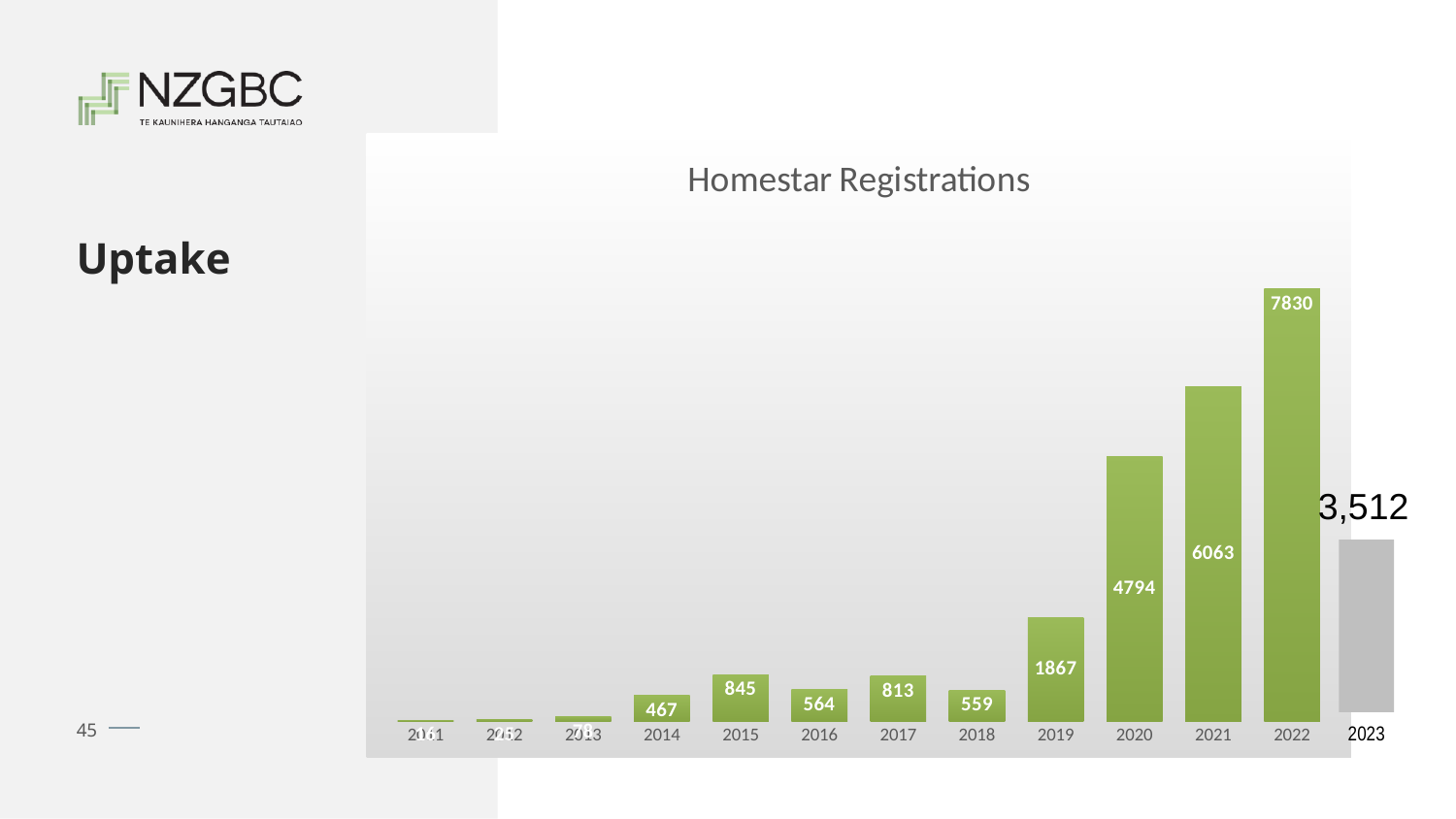
What is the difference between the values for 2022 and 2021? 1767 Which year has the highest number of Homestar Registrations? 2022 What is the difference between the values for 2020 and 2019? 2927 What kind of chart is shown on the slide? bar chart What is the title of the chart? Homestar Registrations What is the value for 2022 in the Homestar Registrations chart? 7830 How many years are shown on the x axis of the chart? 13 Do the values rise or fall from 2019 to 2022? rise What is the value for 2019 in the Homestar Registrations chart? 1867 What is the value for 2014 in the Homestar Registrations chart? 467 What is the value for 2023 in the Homestar Registrations chart? 3,512 Which year has the larger value, 2016 or 2017? 2017